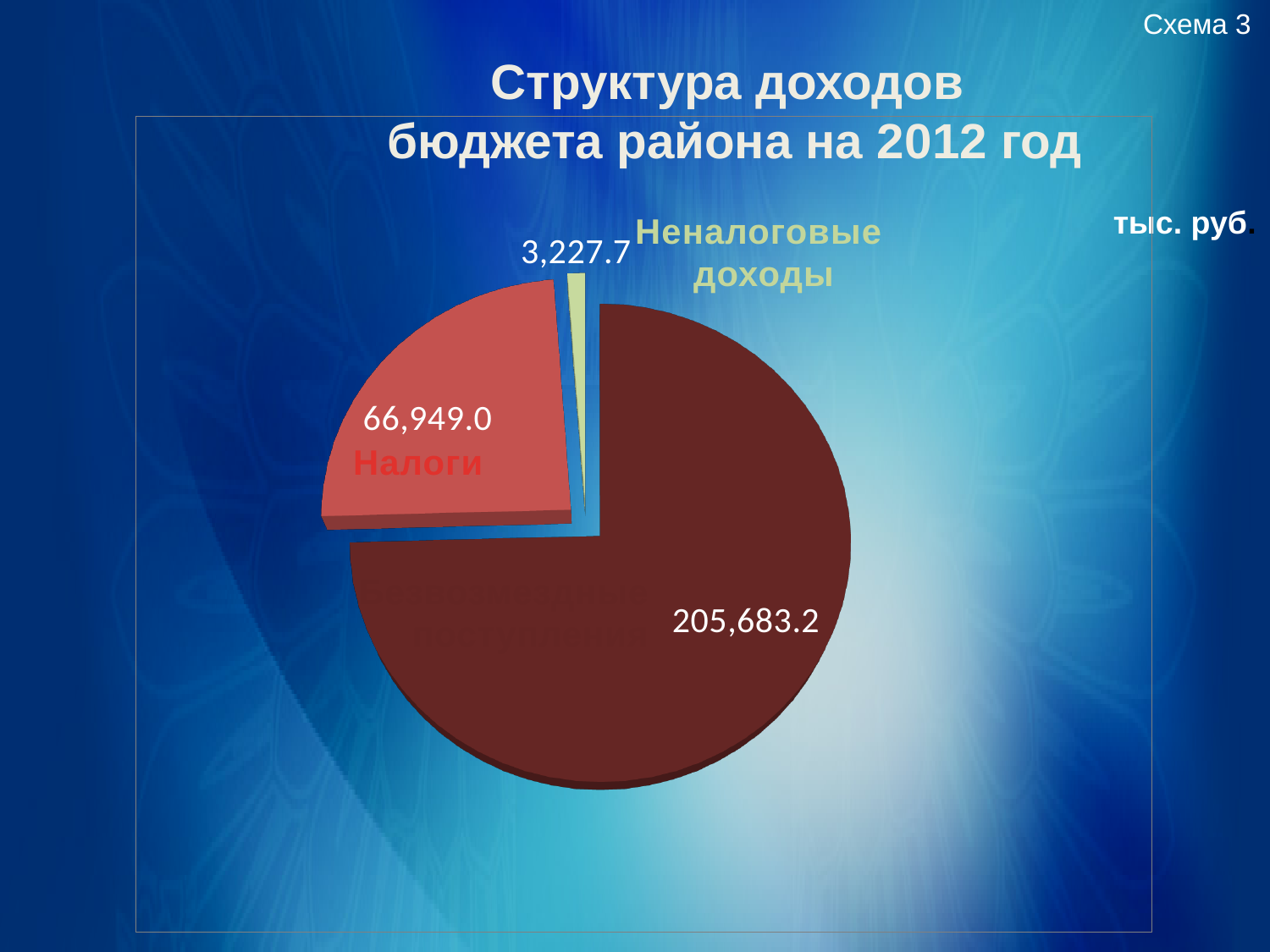
What share of the pie does Налоги represent, to the nearest whole percent? 24% What kind of chart is shown on the slide? pie chart What is the value for Налоги? 66,949.0 What is the value for Неналоговые доходы? 3,227.7 What is the title of the chart? Структура доходов бюджета района на 2012 год What is the value of the largest slice of the pie? 205,683.2 In what units are the values on the chart given? тыс. руб. Which labelled category has the smallest slice? Неналоговые доходы Which is larger, Налоги or Неналоговые доходы? Налоги What is the total of all slices in the pie chart? 275,859.9 What is the difference between Налоги and Неналоговые доходы? 63,721.3 How many slices does the pie chart have? 3